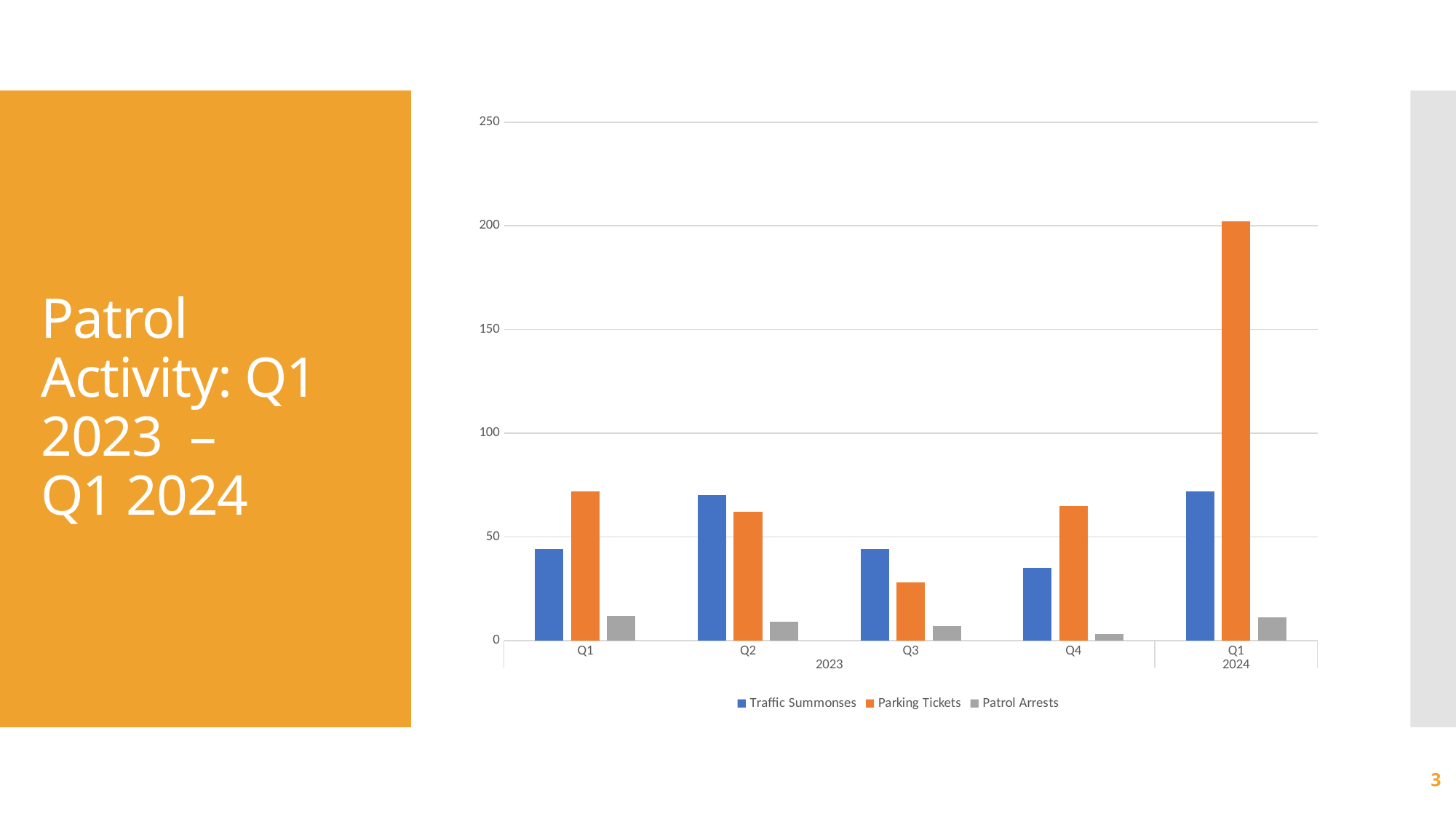
Do Patrol Arrests rise or fall from Q1 2023 to Q4 2023? Fall What kind of chart is shown on the slide? Bar chart Is the value for Parking Tickets in Q3 2023 greater or less than 50? less Is the value for Traffic Summonses in Q2 2023 greater or less than 50? greater In which quarter are Parking Tickets lowest? Q3 2023 Is the value for Parking Tickets in Q1 2024 greater or less than 150? greater In which quarter are Parking Tickets highest? Q1 2024 In which quarter are Traffic Summonses lowest? Q4 2023 In which quarter are Patrol Arrests lowest? Q4 2023 How many series does the legend list? 3 In Q4 2023, which is larger: Traffic Summonses or Parking Tickets? Parking Tickets How many quarters are plotted along the x axis? 5